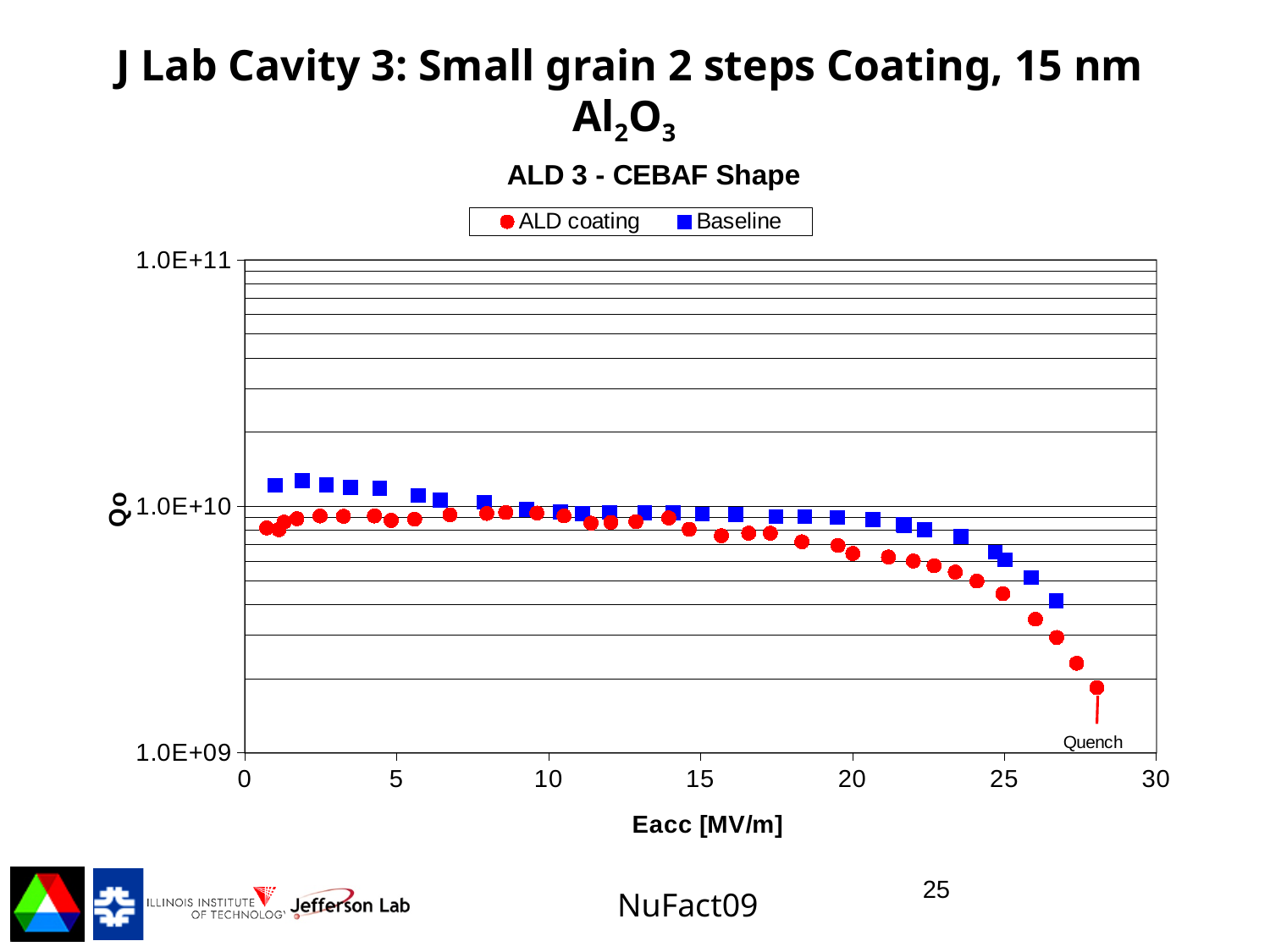
What kind of chart is shown on the slide? scatter chart At Eacc of about 25 MV/m, which series has the higher Q0, ALD coating or Baseline? Baseline Does the Q0 of the ALD coating series rise or fall as Eacc increases beyond about 15 MV/m? fall Is the ALD coating value at Eacc of about 28 MV/m greater or less than 1.0E+09? greater At Eacc of about 2 MV/m, which series has the higher Q0, ALD coating or Baseline? Baseline Is the Baseline value at Eacc of about 2 MV/m greater or less than 1.0E+10? greater What annotation is written near the last ALD coating point at the right of the chart? Quench What is the label of the x axis? Eacc [MV/m] Is the ALD coating value at Eacc of about 28 MV/m greater or less than 1.0E+10? less Which series extends to the highest Eacc value on the chart? ALD coating What is the title of the chart? ALD 3 - CEBAF Shape How many series does the legend list? 2